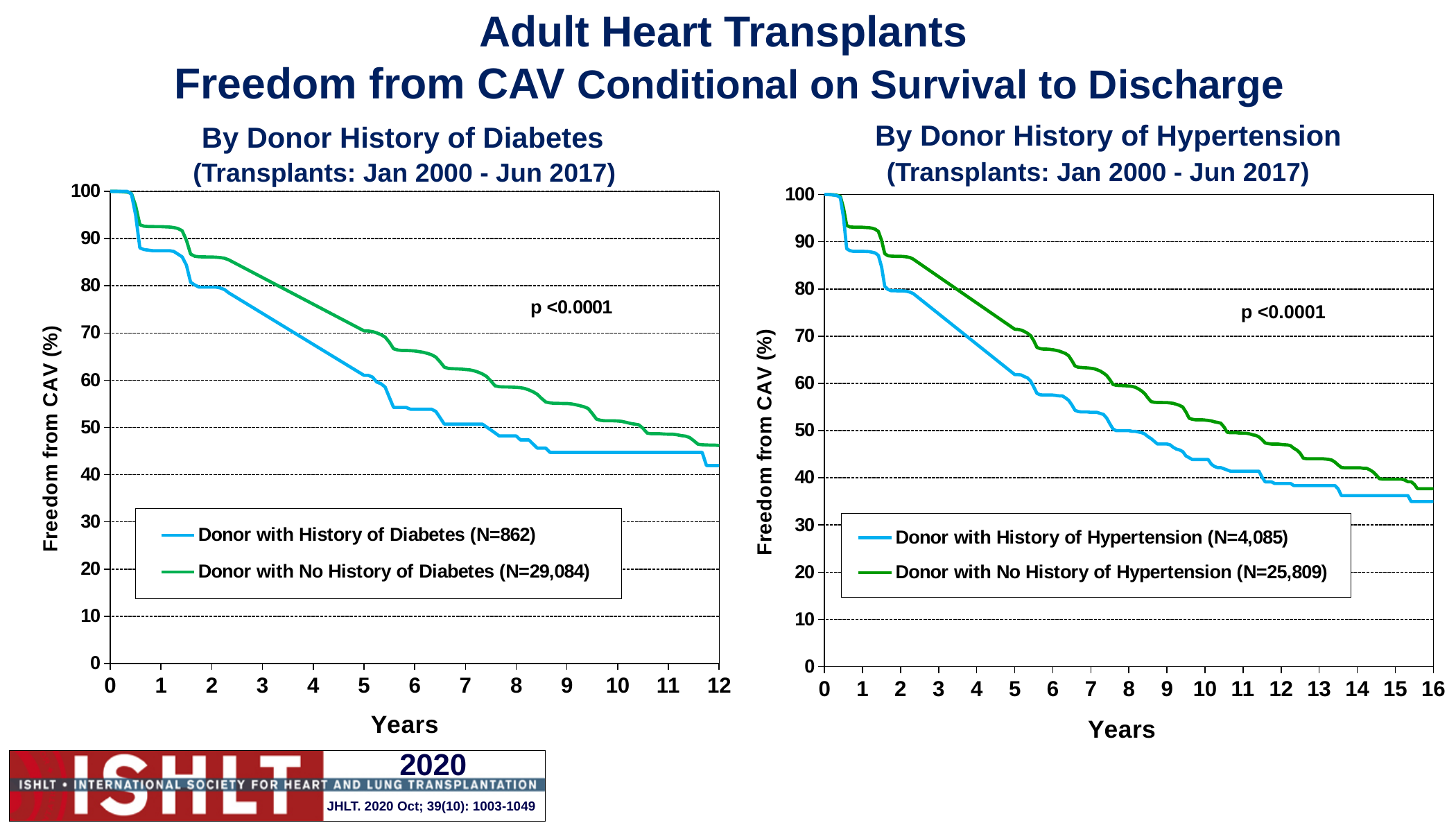
In the 'By Donor History of Diabetes' chart, do the values rise or fall as years increase? fall In the 'By Donor History of Hypertension' chart, is the value for Donor with History of Hypertension at year 10 greater or less than 50? less In the 'By Donor History of Hypertension' chart, which series is higher at year 12: Donor with History of Hypertension or Donor with No History of Hypertension? Donor with No History of Hypertension In the 'By Donor History of Hypertension' chart, what is the N for Donor with History of Hypertension shown in the legend? N=4,085 How many series does the legend of the 'By Donor History of Hypertension' chart list? 2 What kind of chart is the 'By Donor History of Diabetes' chart? line chart What p-value is shown on the 'By Donor History of Diabetes' chart? p <0.0001 In the 'By Donor History of Diabetes' chart, which series is higher at year 6: Donor with History of Diabetes or Donor with No History of Diabetes? Donor with No History of Diabetes In the 'By Donor History of Diabetes' chart, what is the freedom from CAV (%) for both series at year 0? 100 In the 'By Donor History of Diabetes' chart, is the value for Donor with History of Diabetes at year 10 greater or less than 50? less